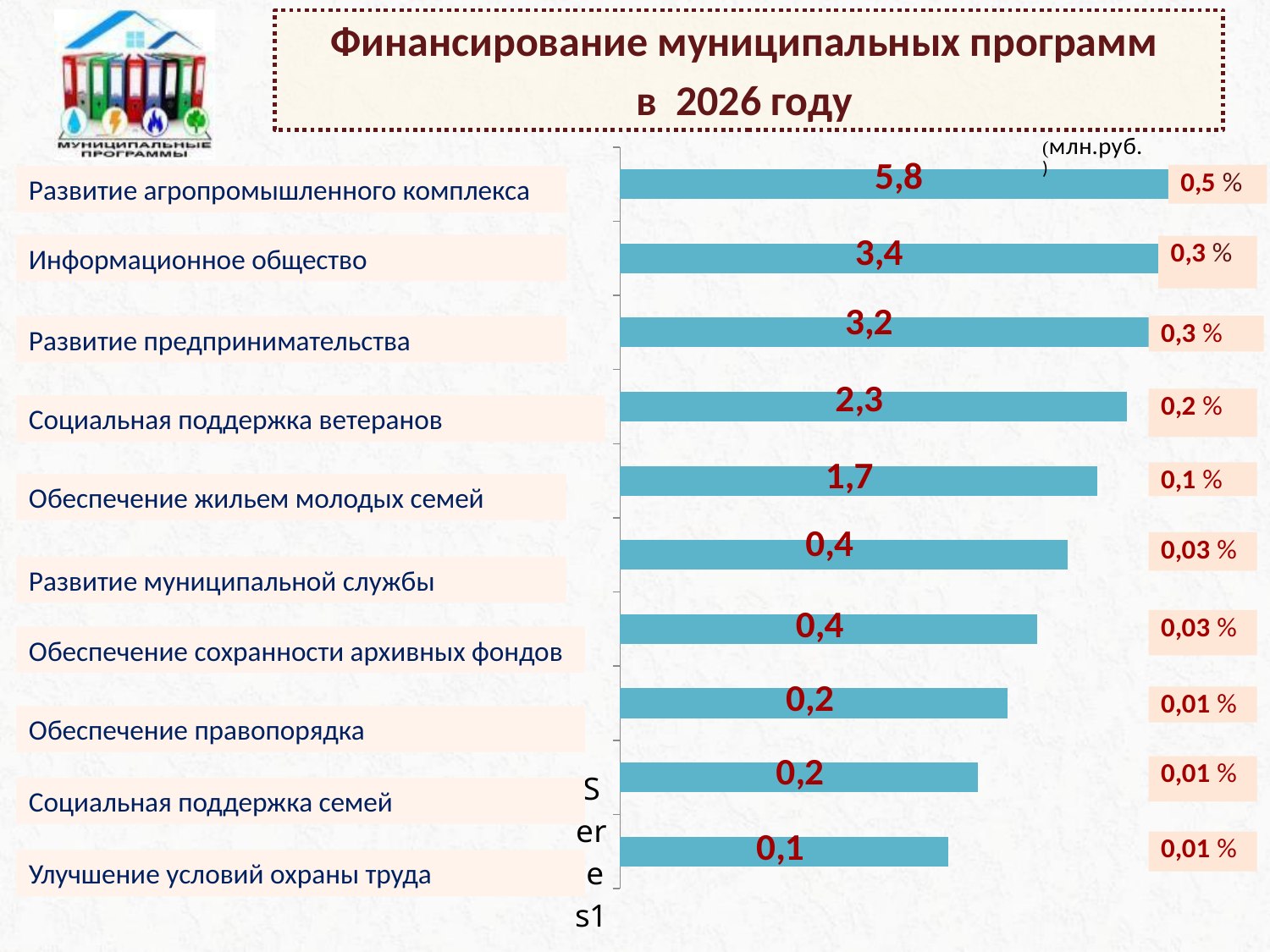
What is the value for Обеспечение жильем молодых семей? 1,7 Do the values rise or fall going from the top bar to the bottom bar? Fall What is the value for Развитие агропромышленного комплекса? 5,8 Which program has the highest value? Развитие агропромышленного комплекса Which program has the lowest value? Улучшение условий охраны труда Which is larger: the value for Информационное общество or for Развитие предпринимательства? Информационное общество What kind of chart is shown on the slide? Bar chart What is the difference between the values for Развитие агропромышленного комплекса and Информационное общество? 2,4 What unit is indicated for the chart values? млн.руб. What is the value for Социальная поддержка ветеранов? 2,3 What is the value for Улучшение условий охраны труда? 0,1 How many programs are shown in the chart? 10